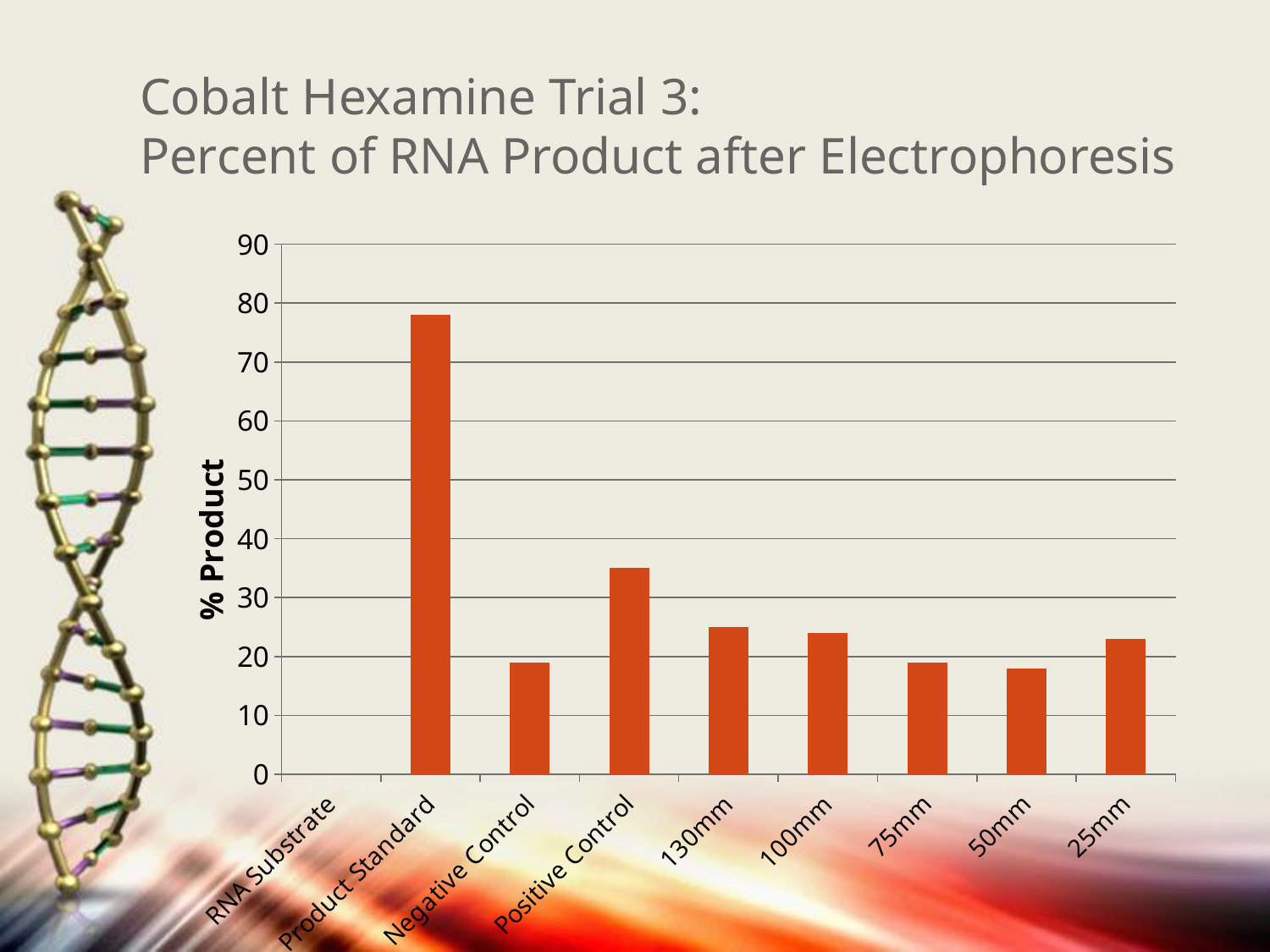
How many categories are listed along the x axis? 9 What kind of chart is shown on the slide? bar chart Which is larger, the value for 130mm or the value for 50mm? 130mm Which is larger, the value for Product Standard or the value for Positive Control? Product Standard What is the label on the vertical axis? % Product Is the value for 25mm greater or less than 20? greater Is the value for Positive Control greater or less than 40? less Is the value for 130mm greater or less than 30? less Which category has the highest % Product? Product Standard Which is larger, the value for Positive Control or the value for 130mm? Positive Control